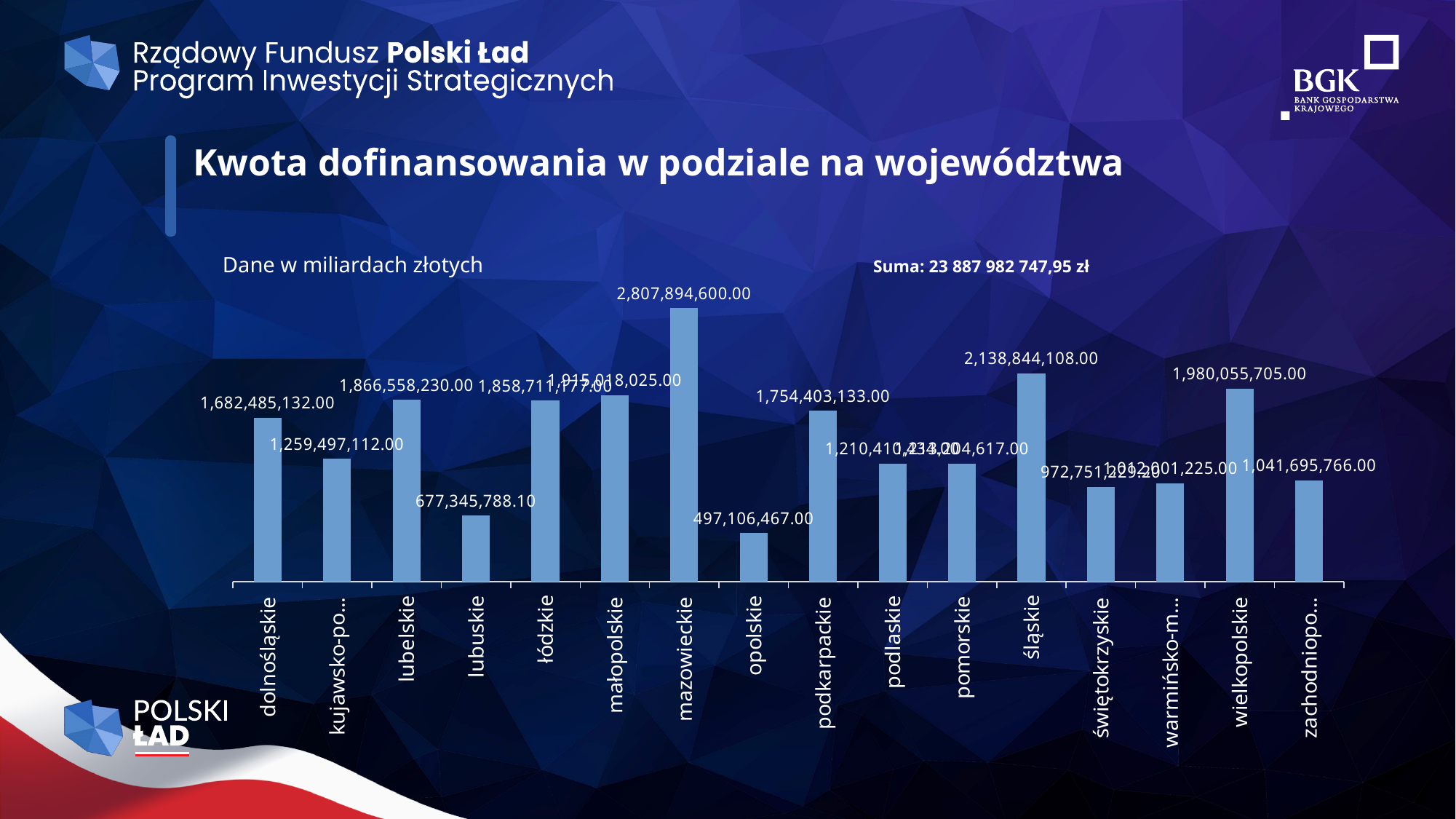
What is the value for lubuskie? 677,345,788.10 What is the value for opolskie? 497,106,467.00 What is the title of the chart? Kwota dofinansowania w podziale na województwa What type of chart is shown on the slide? bar chart What is the difference between the values for mazowieckie and opolskie? 2,310,788,133.00 Which voivodeship has the highest value? mazowieckie Which has the larger value, śląskie or wielkopolskie? śląskie What is the value for śląskie? 2,138,844,108.00 Which voivodeship has the lowest value? opolskie What is the value for mazowieckie? 2,807,894,600.00 How many voivodeships (categories) are shown on the x axis? 16 What total sum (Suma) is printed on the slide? 23 887 982 747,95 zł